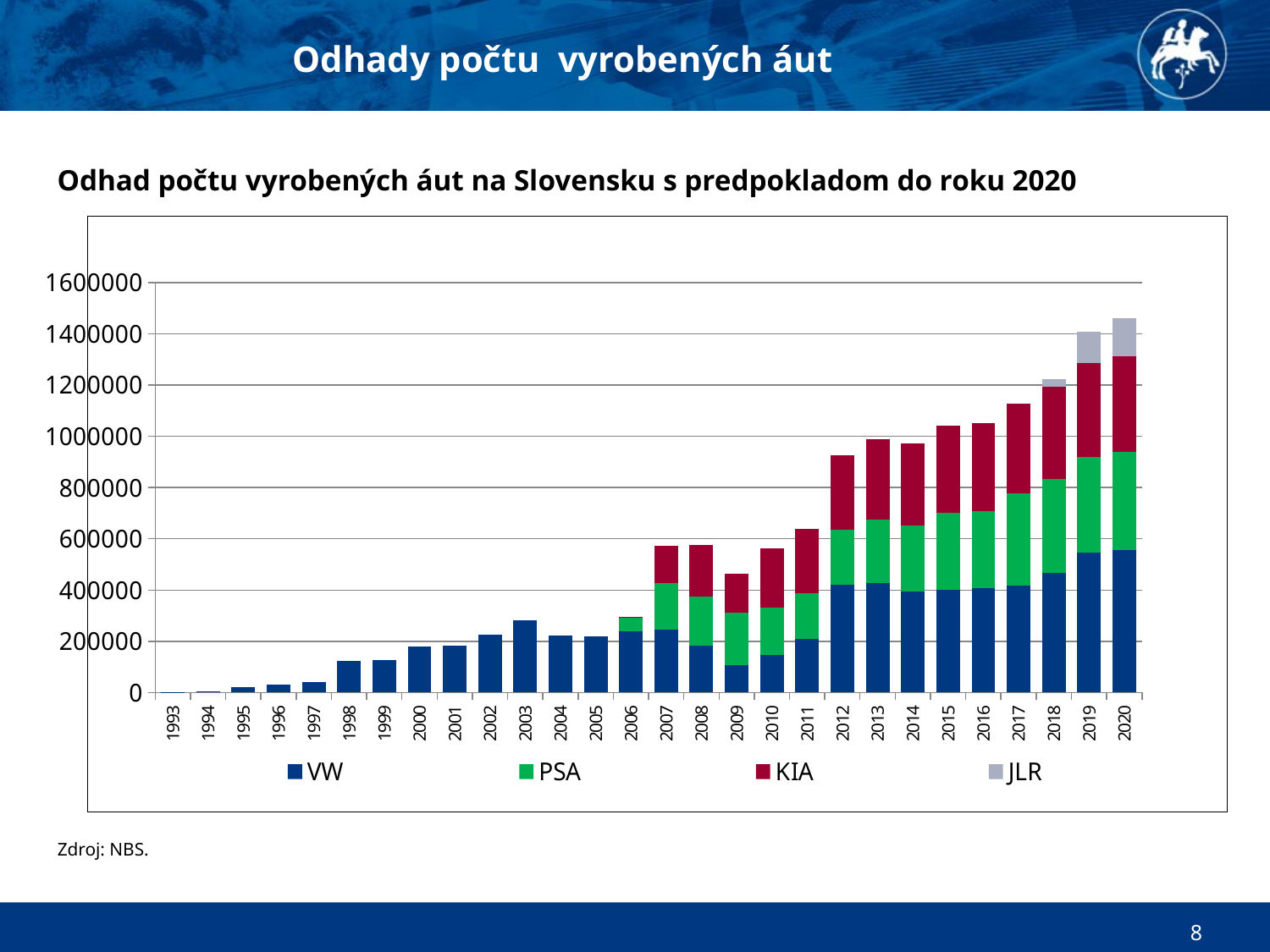
Which year has the larger total, 2011 or 2012? 2012 How many series does the legend list? 4 In which year does the JLR series first appear in the stacked bars? 2018 How many years are shown on the x axis? 28 Is the total value for 2009 greater or less than 600000? less Is the total value for 2012 greater or less than 800000? greater Which year has the highest total number of cars produced? 2020 What kind of chart is shown on the slide? Stacked bar chart Which series are listed in the legend? VW, PSA, KIA, JLR Is the total value for 2020 greater or less than 1400000? greater Which year has the lowest total number of cars produced? 1993 Do the total values generally rise or fall from 1993 to 2020? Rise